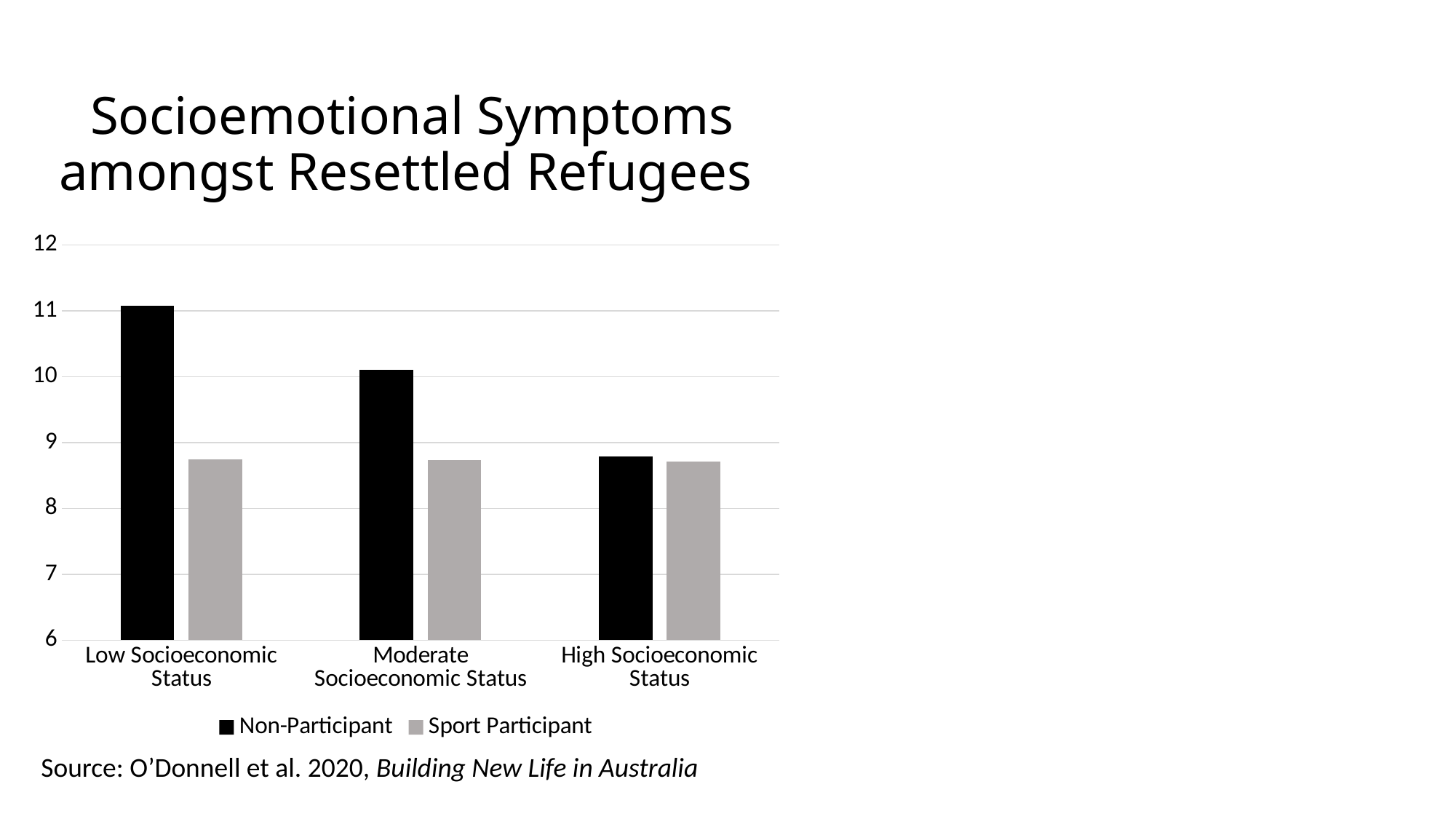
How many series does the legend list? 2 Is the Non-Participant value for Low Socioeconomic Status greater or less than 10? greater What is the title of the chart? Socioemotional Symptoms amongst Resettled Refugees Which category has the highest Non-Participant value? Low Socioeconomic Status For Low Socioeconomic Status, which is larger: the Non-Participant value or the Sport Participant value? Non-Participant How many socioeconomic status categories are shown on the x axis? 3 What kind of chart is shown on the slide? bar chart Do the Non-Participant values rise or fall moving from Low to High Socioeconomic Status? fall Is the Sport Participant value for Low Socioeconomic Status greater or less than 9? less Which category has the lowest Non-Participant value? High Socioeconomic Status For Moderate Socioeconomic Status, which is larger: the Non-Participant value or the Sport Participant value? Non-Participant Is the Non-Participant value for Moderate Socioeconomic Status greater or less than 11? less